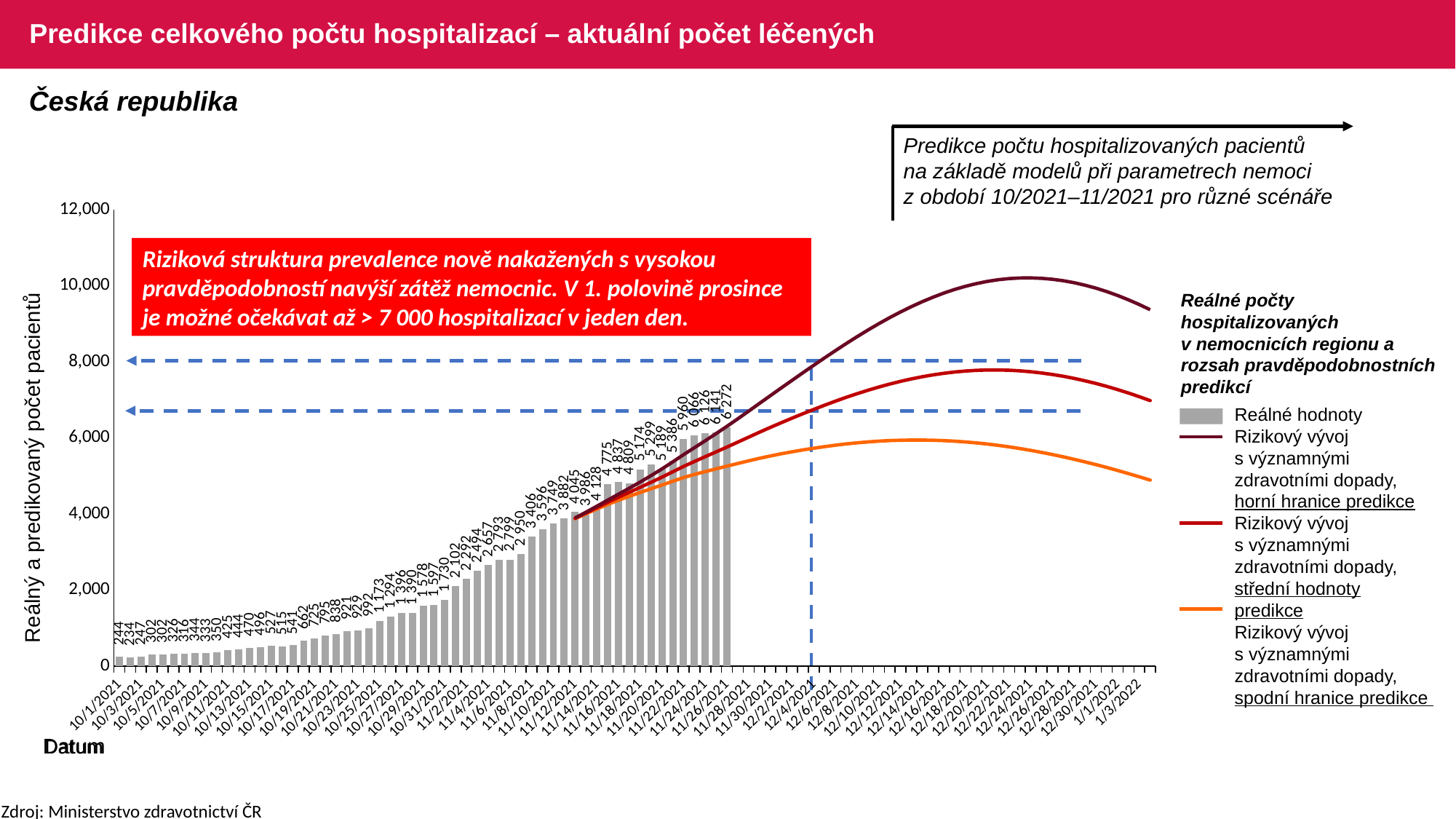
What is the difference between the last bar (6 272) and the first bar (244)? 6 028 Which bar has the highest real value, and what is it? The last bar, 6 272 What is the value of the last (most recent) bar of real values? 6 272 Do the real hospitalization values rise or fall from 10/1/2021 to the end of November 2021? rise What is the label of the vertical axis? Reálný a predikovaný počet pacientů How many series does the chart legend list? 4 What is the value of the first bar, for 10/1/2021? 244 Is the peak of the upper prediction line (horní hranice predikce) greater or less than 8,000? greater Which is larger: the bar for 10/1/2021 or the last bar of real values? The last bar of real values What is the lowest value among the real-value bars? 234 Is the peak of the lower prediction line (spodní hranice predikce) greater or less than 8,000? less What kind of chart is shown on the slide? A combined bar and line chart